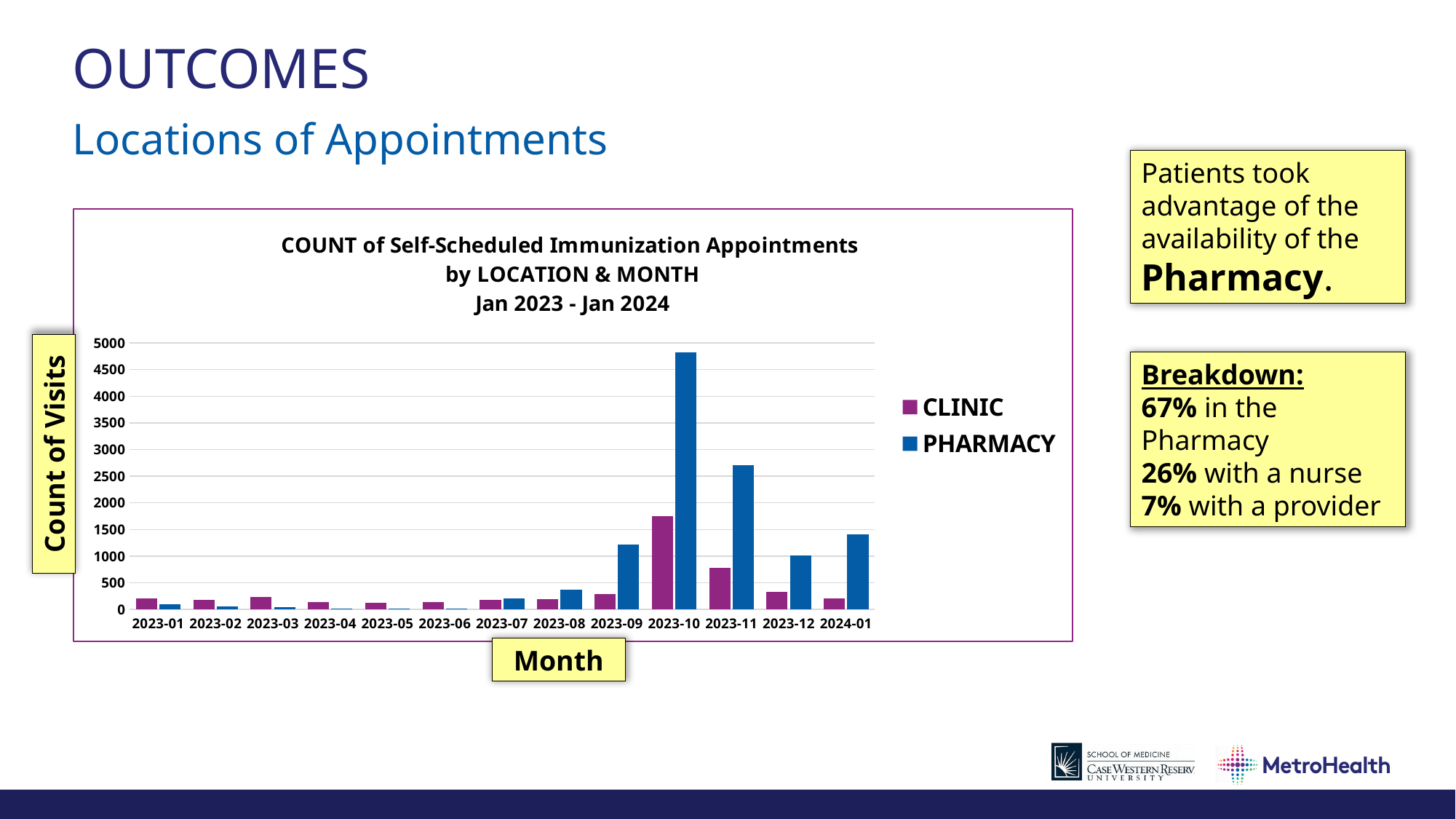
Is the PHARMACY value for 2023-10 greater or less than 4500? greater In which month is the CLINIC bar highest? 2023-10 Do the PHARMACY values rise or fall from 2023-07 to 2023-10? rise In 2023-11, which series has the larger value, CLINIC or PHARMACY? PHARMACY What kind of chart is shown on the slide? bar chart In which month is the PHARMACY bar highest? 2023-10 Is the PHARMACY value for 2023-11 greater or less than 2000? greater Is the CLINIC value for 2023-10 greater or less than 2000? less How many series does the chart legend list? 2 How many months are shown on the x axis of the chart? 13 Which colour represents the PHARMACY series in the chart? blue